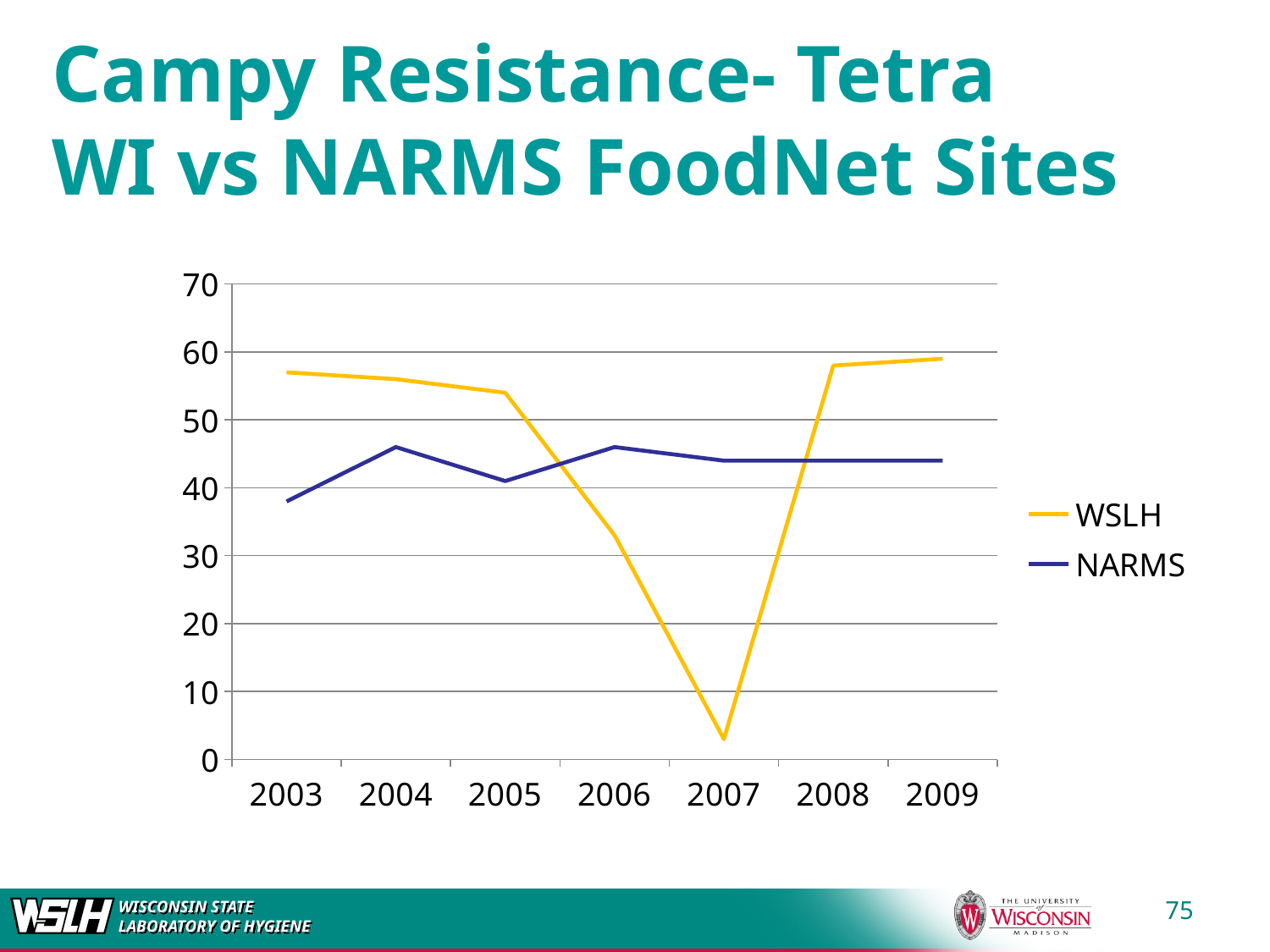
In 2003, which series has the larger value, WSLH or NARMS? WSLH Is the WSLH value for 2007 greater or less than 10? less What colour is the WSLH line in the legend? yellow What kind of chart is shown on the slide? line chart In 2007, which series has the larger value, WSLH or NARMS? NARMS Is the NARMS value for 2009 greater or less than 40? greater Does the WSLH line rise or fall from 2003 to 2007? fall How many years are plotted along the x axis? 7 In which year is the WSLH value lowest? 2007 How many series does the legend list? 2 Is the NARMS value for 2003 greater or less than 40? less